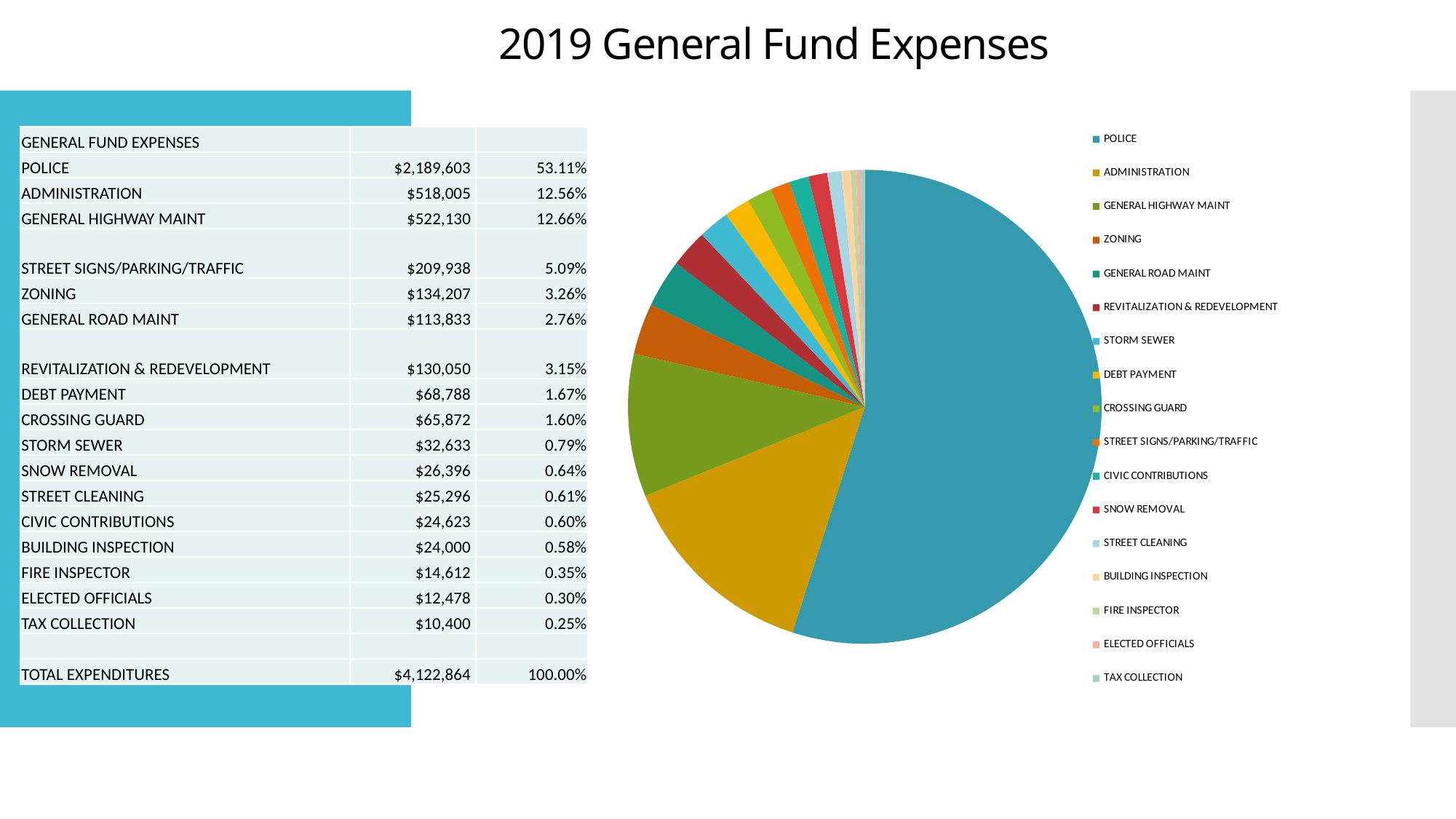
Which is larger, the expense for DEBT PAYMENT or for CROSSING GUARD? DEBT PAYMENT What is the expense value for GENERAL HIGHWAY MAINT? $522,130 Which category has the smallest expense? TAX COLLECTION What share of total expenditures does POLICE represent? 53.11% What is the title of the slide containing the pie chart? 2019 General Fund Expenses What is the expense value for ADMINISTRATION? $518,005 What is the difference between the expense for ZONING and the expense for GENERAL ROAD MAINT? $20,374 What kind of chart is shown on the slide? pie chart How many categories does the pie chart's legend list? 17 What is the total of all expenditures shown? $4,122,864 Which category is the largest slice of the pie chart? POLICE What share of total expenditures does ZONING represent? 3.26%